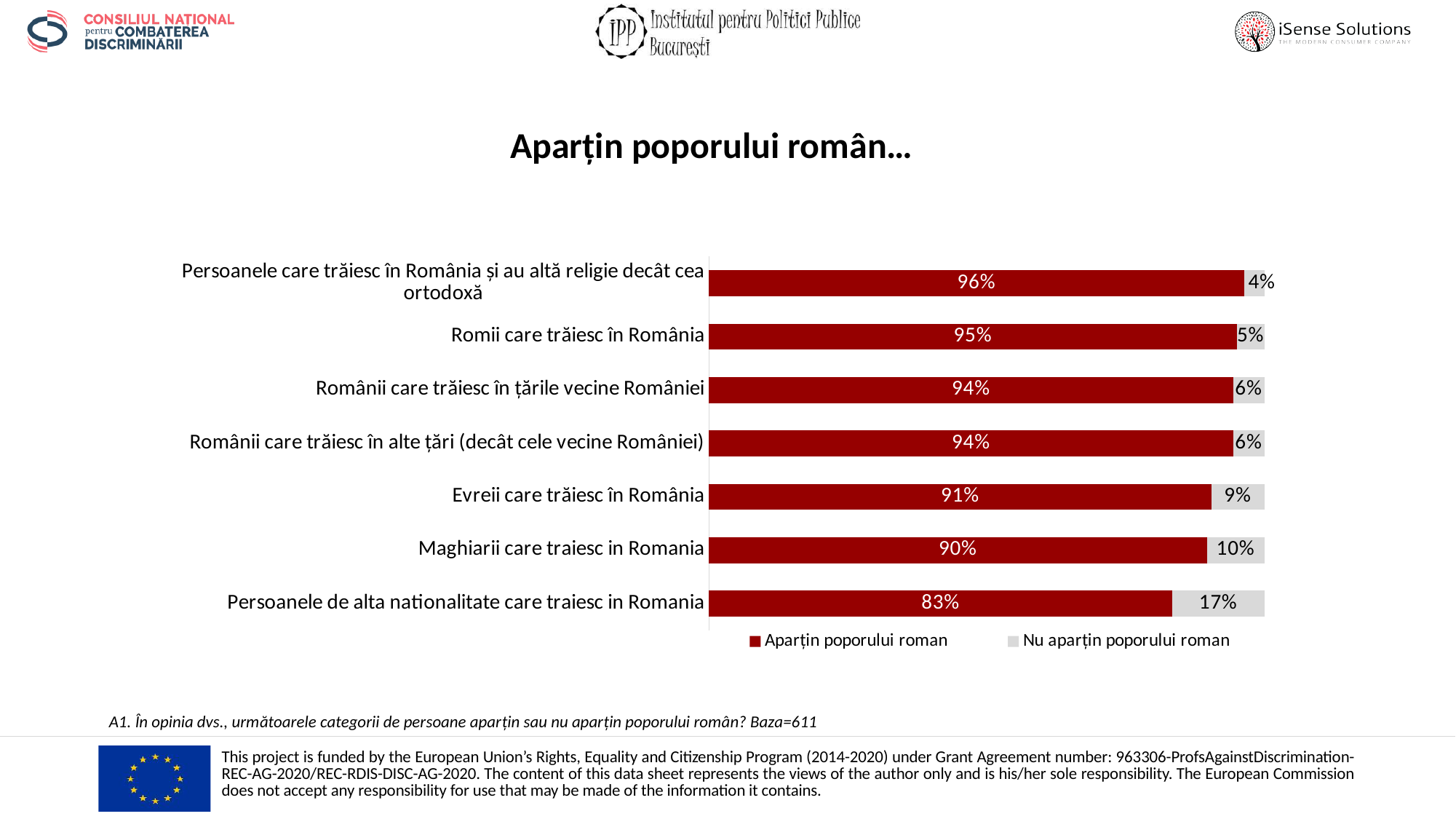
What type of chart is shown on the slide? Stacked bar chart What percentage of respondents say that Romii care trăiesc în România belong to the Romanian people (Aparțin poporului roman)? 95% How many categories are shown in the chart? 7 Which category has the highest 'Aparțin poporului roman' value? Persoanele care trăiesc în România și au altă religie decât cea ortodoxă How many series does the legend list? 2 What is the difference between the 'Aparțin poporului roman' values for Maghiarii care traiesc in Romania and Persoanele de alta nationalitate care traiesc in Romania? 7 percentage points Which category has the lowest 'Aparțin poporului roman' value? Persoanele de alta nationalitate care traiesc in Romania What is the 'Aparțin poporului roman' value for Evreii care trăiesc în România? 91% What is the total of the stacked bar for Maghiarii care traiesc in Romania? 100% What is the title of the chart? Aparțin poporului român... Which is larger: the 'Nu aparțin poporului roman' value for Evreii care trăiesc în România or for Romii care trăiesc în România? Evreii care trăiesc în România What is the 'Nu aparțin poporului roman' value for Persoanele de alta nationalitate care traiesc in Romania? 17%